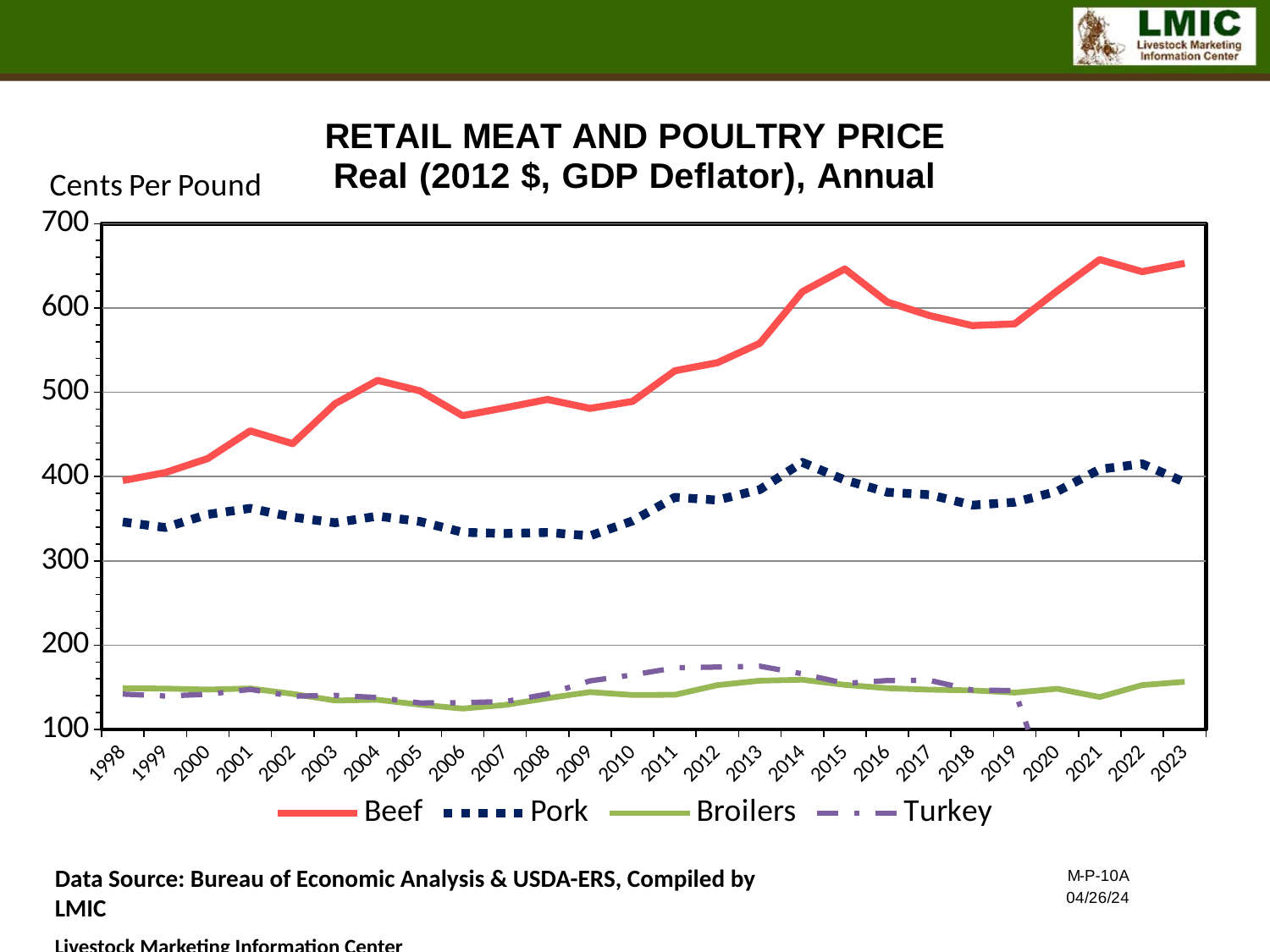
Is the value for Beef in 2006 greater or less than 500? less Is the value for Pork in 2009 greater or less than 350? less Is the value for Beef in 2015 greater or less than 600? greater What unit label is shown above the y axis? Cents Per Pound In 2023, which is larger, the value for Beef or the value for Pork? Beef Which series has the highest values across the whole chart? Beef How many years are plotted along the x axis? 26 In 2012, which is larger, the value for Broilers or the value for Turkey? Turkey How many series does the legend list? 4 What kind of chart is shown on the slide? line chart Overall, does the Beef line rise or fall from 1998 to 2023? rise